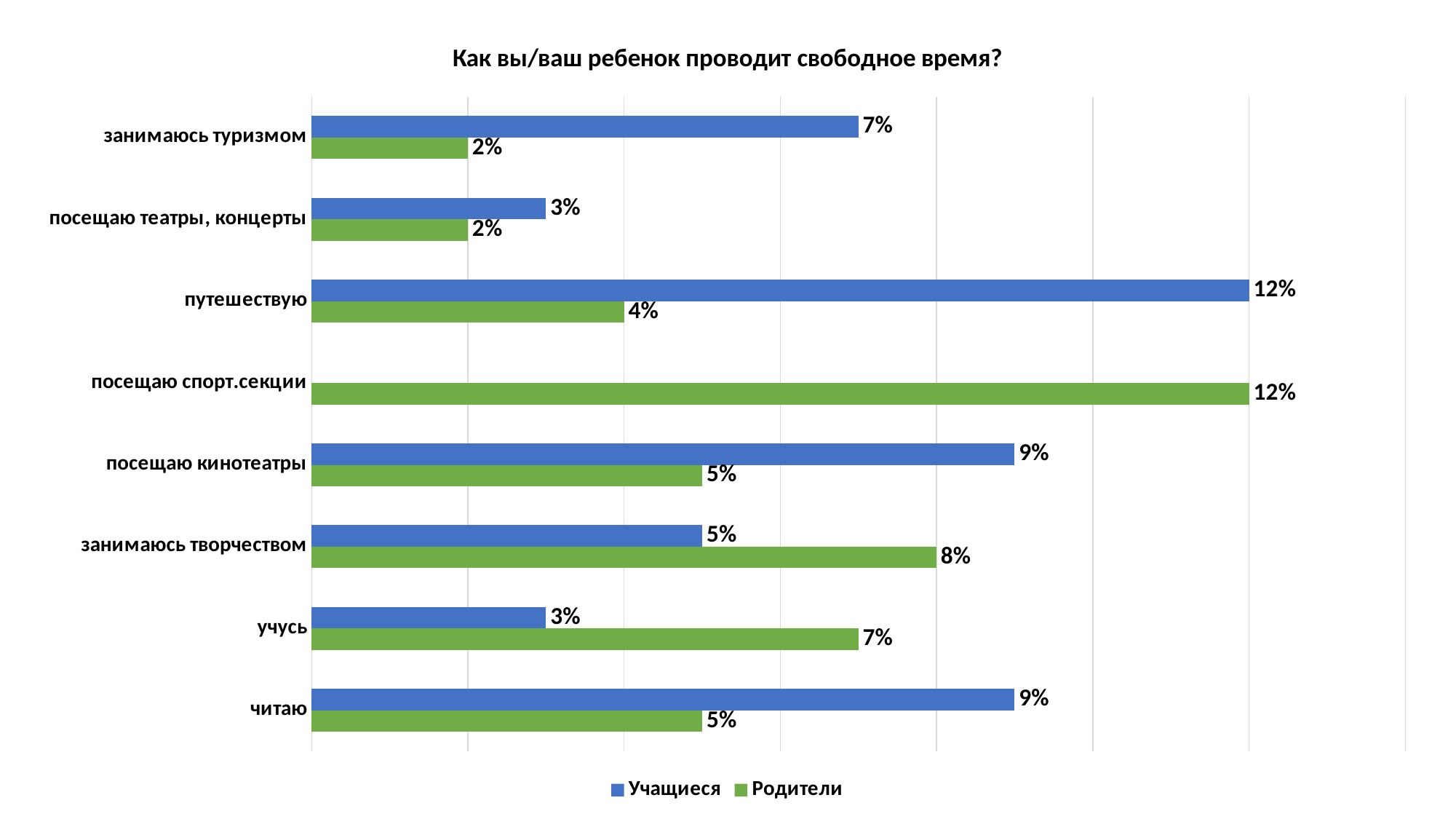
What is the value for Родители in the category посещаю спорт.секции? 12% Which category has the highest value for Родители? посещаю спорт.секции What is the value for Учащиеся in the category занимаюсь туризмом? 7% What is the difference between the Учащиеся and Родители values in the category путешествую? 8% In the category учусь, which series has the larger value, Учащиеся or Родители? Родители How many categories are shown on the chart? 8 Which category has the highest value for Учащиеся? путешествую What is the title of the chart? Как вы/ваш ребенок проводит свободное время? How many series does the legend list? 2 What is the value for Родители in the category занимаюсь творчеством? 8% What is the value for Учащиеся in the category путешествую? 12% What type of chart is shown on the slide? bar chart